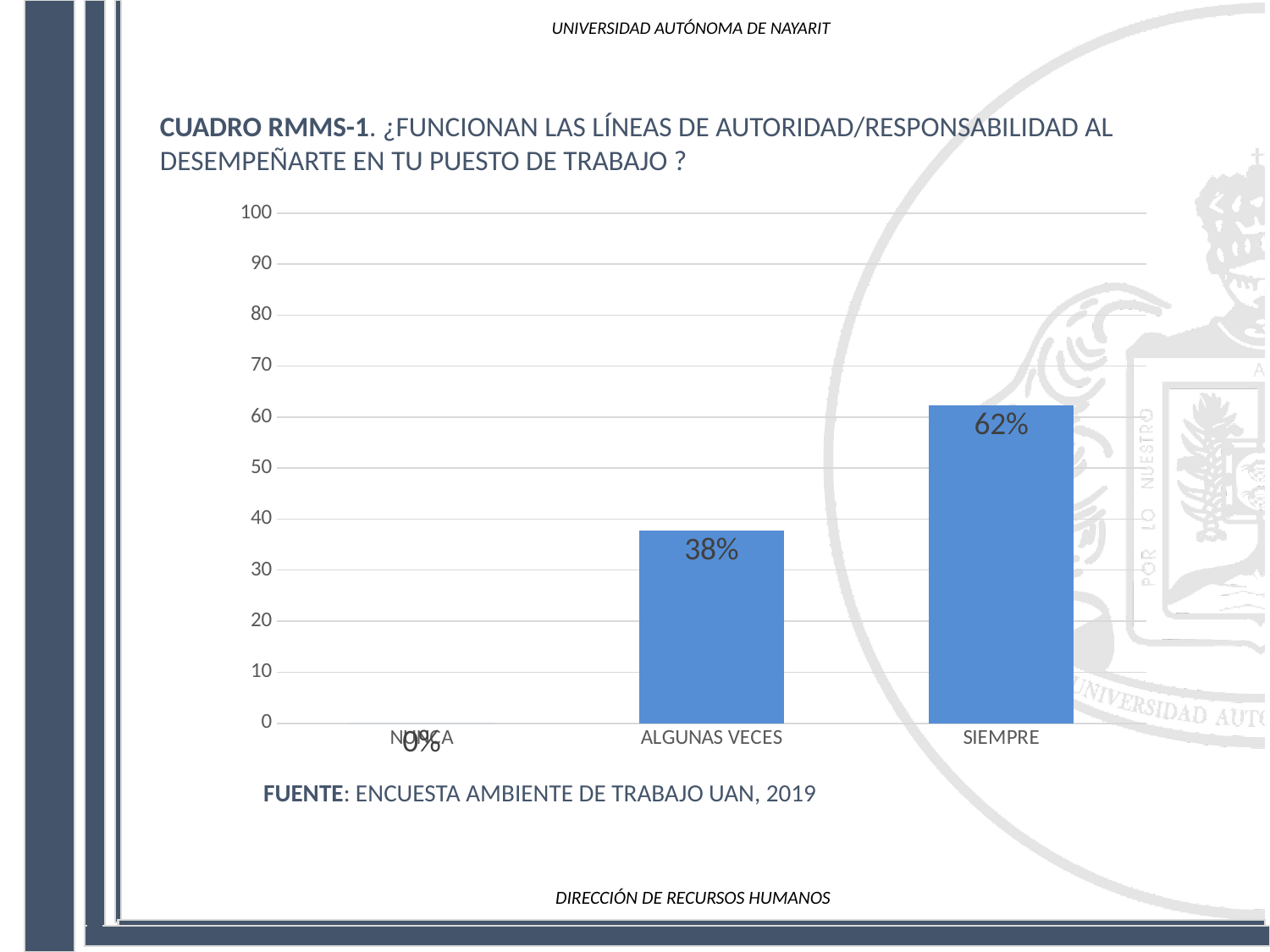
What is the value for SIEMPRE? 62% Which category has the lowest value? NUNCA What kind of chart is shown on the slide? bar chart Which is larger, the value for ALGUNAS VECES or the value for SIEMPRE? SIEMPRE Do the values rise or fall from left to right along the x axis? rise What is the value for NUNCA? 0% What is the value for ALGUNAS VECES? 38% Which category has the highest value? SIEMPRE What is the difference between the values for SIEMPRE and ALGUNAS VECES? 24% How many categories are shown on the x axis? 3 Is the value for SIEMPRE greater or less than 50? greater Is the value for ALGUNAS VECES greater or less than 40? less